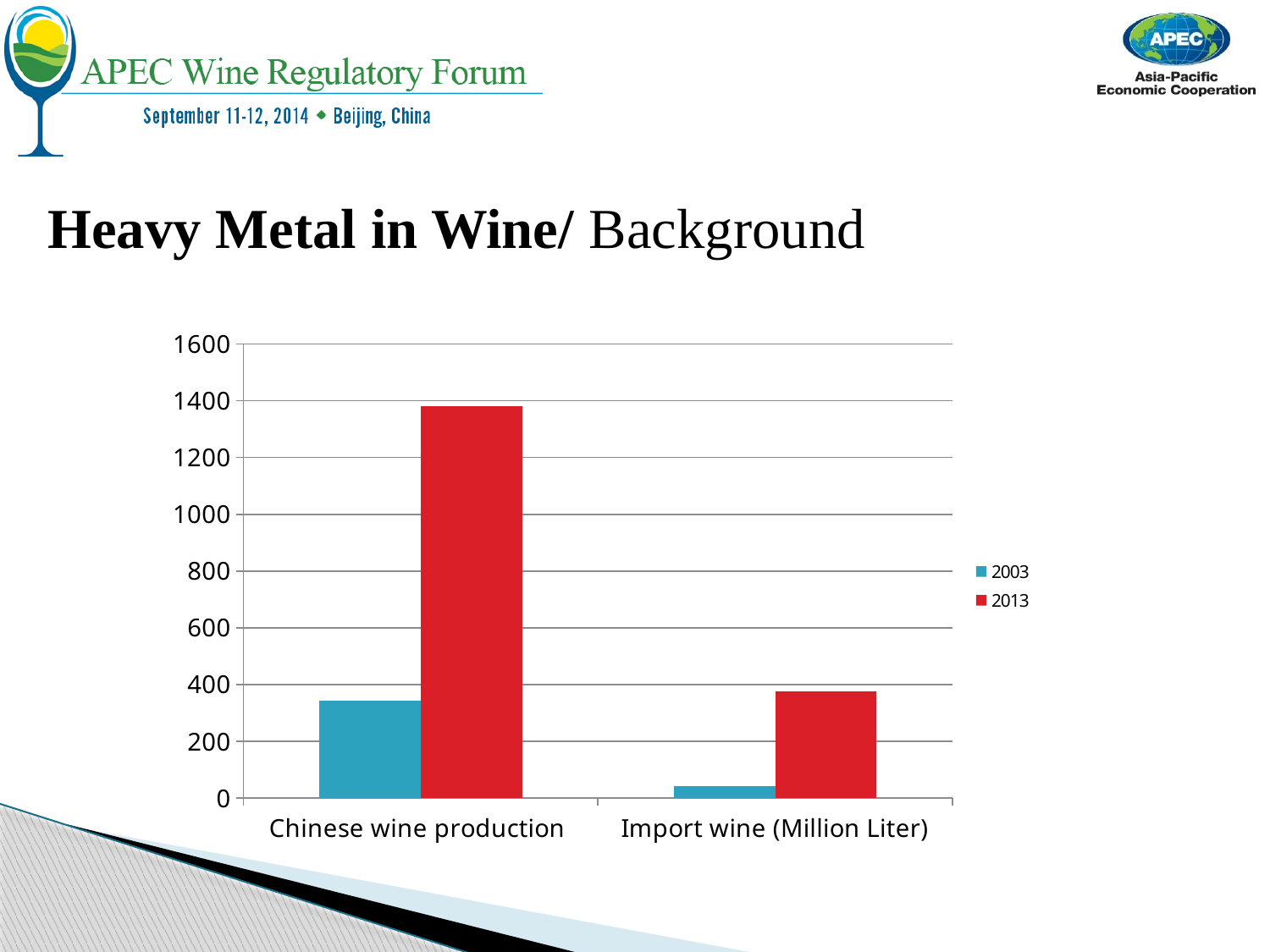
Which years are listed in the legend? 2003 and 2013 How many categories are shown on the x axis? 2 Which bar is the tallest in the chart? Chinese wine production, 2013 How many series does the legend list? 2 Which bar is the shortest in the chart? Import wine (Million Liter), 2003 Is the 2003 value for Import wine (Million Liter) greater or less than 200? less What colour are the bars for the 2013 series? red Is the 2003 value for Chinese wine production greater or less than 400? less What kind of chart is shown on the slide? bar chart Which category has the higher 2013 value, Chinese wine production or Import wine (Million Liter)? Chinese wine production Is the 2013 value for Chinese wine production greater or less than 1200? greater